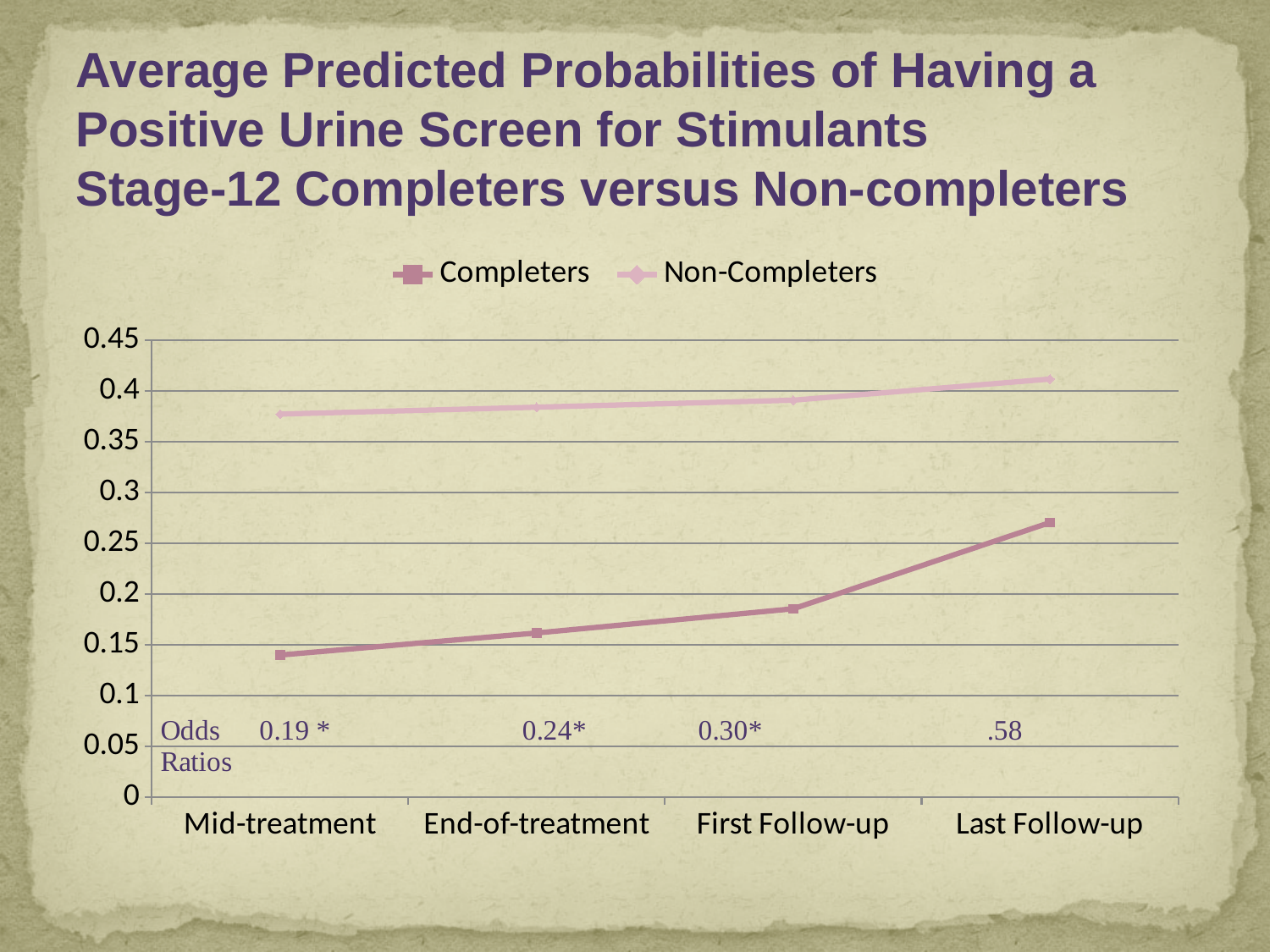
Do the Completers values rise or fall from Mid-treatment to Last Follow-up? rise Which series has the higher value at Mid-treatment, Completers or Non-Completers? Non-Completers Is the Completers value at Last Follow-up greater or less than 0.25? greater At which time point is the Completers value highest? Last Follow-up How many time points are plotted along the x axis? 4 At which time point is the Completers value lowest? Mid-treatment Is the Completers value at Mid-treatment greater or less than 0.15? less Which series has the higher value at Last Follow-up, Completers or Non-Completers? Non-Completers What kind of chart is shown on the slide? line chart What are the two series named in the legend? Completers and Non-Completers How many series does the legend list? 2 Is the Non-Completers value at Mid-treatment greater or less than 0.4? less